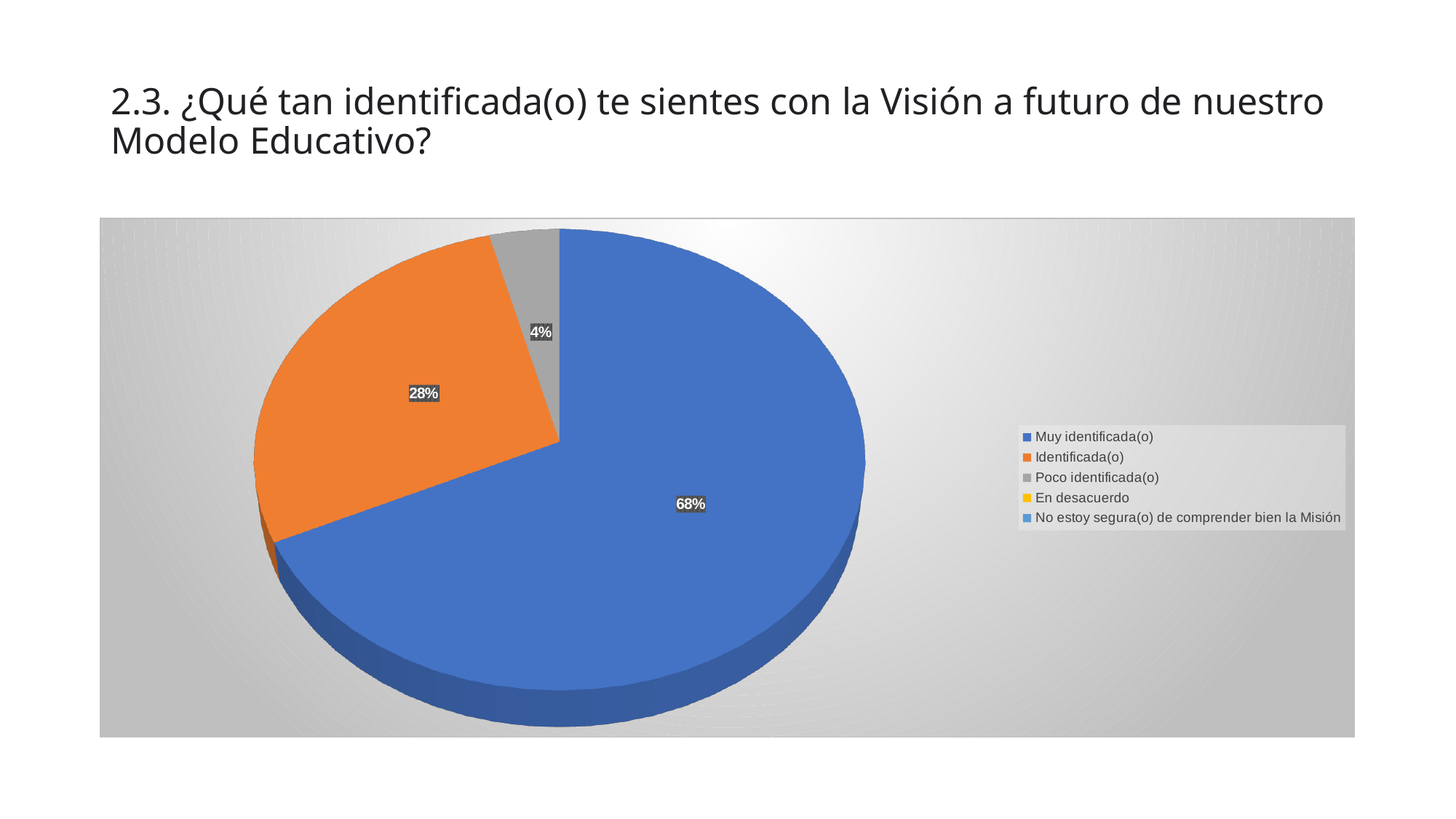
What percentage of respondents answered "Identificada(o)"? 28% How many slices of the pie have a visible data label? 3 Which response category has the largest share of the pie? Muy identificada(o) Which is larger, the share for "Identificada(o)" or the share for "Poco identificada(o)"? Identificada(o) What percentage of respondents answered "Muy identificada(o)"? 68% What percentage of respondents answered "Poco identificada(o)"? 4% What is the combined share of "Muy identificada(o)" and "Identificada(o)"? 96% What is the difference in percentage points between "Muy identificada(o)" and "Identificada(o)"? 40 Which of the labelled slices is the smallest? Poco identificada(o) What kind of chart is shown on the slide? pie chart How many entries does the legend list? 5 What colour is the slice for "Identificada(o)"? orange